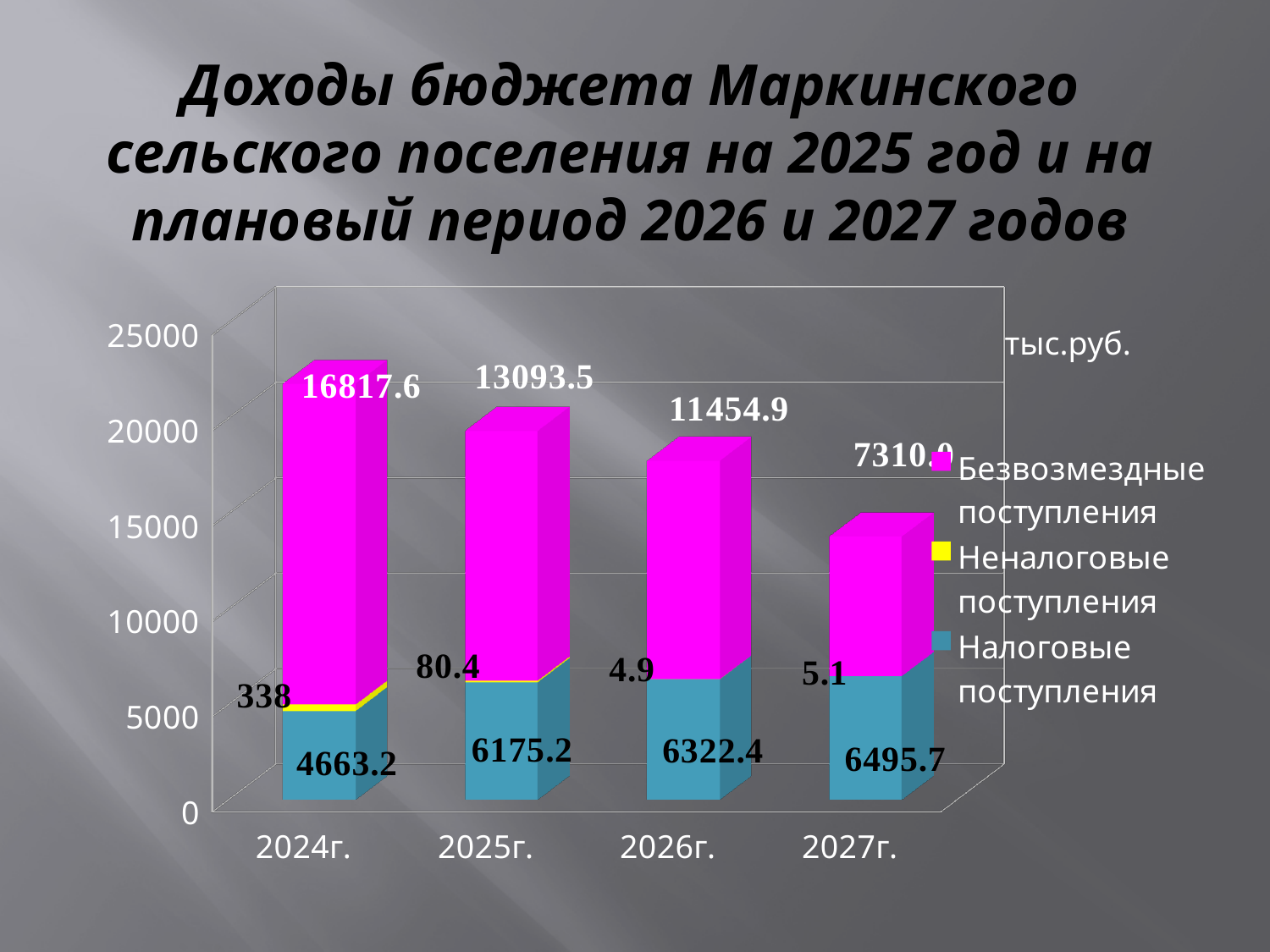
What is the value of Неналоговые поступления for 2026г.? 4.9 In which year is the value of Налоговые поступления the highest? 2027г. In which year is the value of Безвозмездные поступления the lowest? 2027г. What kind of chart is shown on the slide? Stacked bar chart How many series does the legend list? 3 By how much does Налоговые поступления in 2025г. exceed that in 2024г.? 1512 What is the value of Налоговые поступления for 2024г.? 4663.2 How many years (categories) are shown on the x axis? 4 How does the value of Безвозмездные поступления change from 2024г. to 2027г.? It falls What is the total of the stacked bar for 2024г.? 21818.8 In what units are the values on the chart given? тыс.руб. What is the value of Безвозмездные поступления for 2025г.? 13093.5